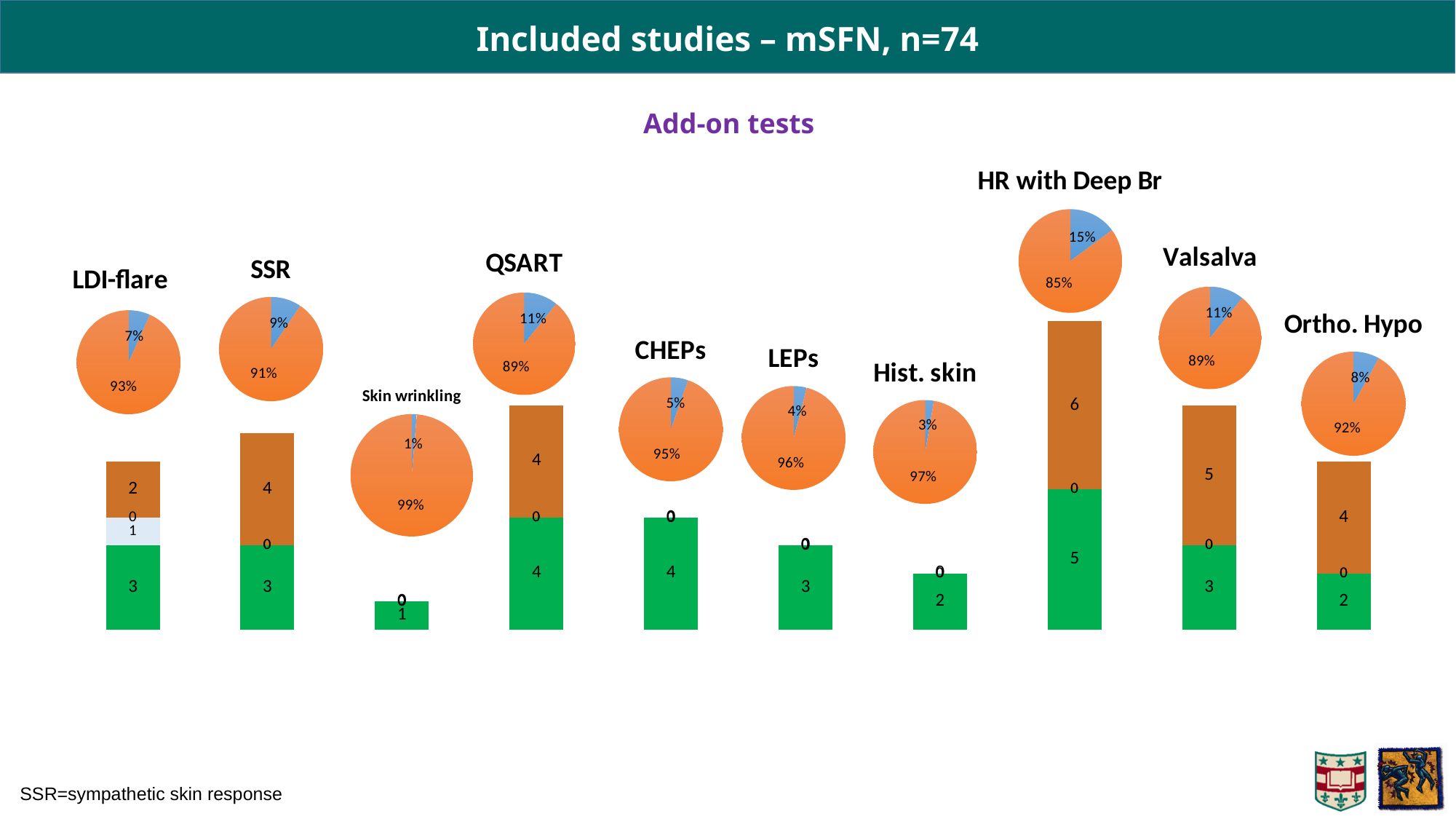
How many add-on tests are shown on the slide, each with its own pie chart? 10 In the HR with Deep Br pie chart, what percentage does the blue slice show? 15% What is the total of the stacked bar under QSART? 8 Across all the pie charts on the slide, which test has the smallest blue slice? Skin wrinkling Across all the pie charts on the slide, which test has the largest blue slice? HR with Deep Br In the Skin wrinkling pie chart, what percentage does the orange slice show? 99% What is the total of the stacked bar under HR with Deep Br? 11 In the LDI-flare pie chart, what percentage does the large orange slice show? 93% In the stacked bar under HR with Deep Br, what is the value of the brown segment? 6 Which stacked bar is taller, the one under Valsalva or the one under Ortho. Hypo? Valsalva What is the difference between the brown segment and the green segment in the stacked bar under Valsalva? 2 What kind of chart is shown below each pie chart on the slide? Stacked bar chart